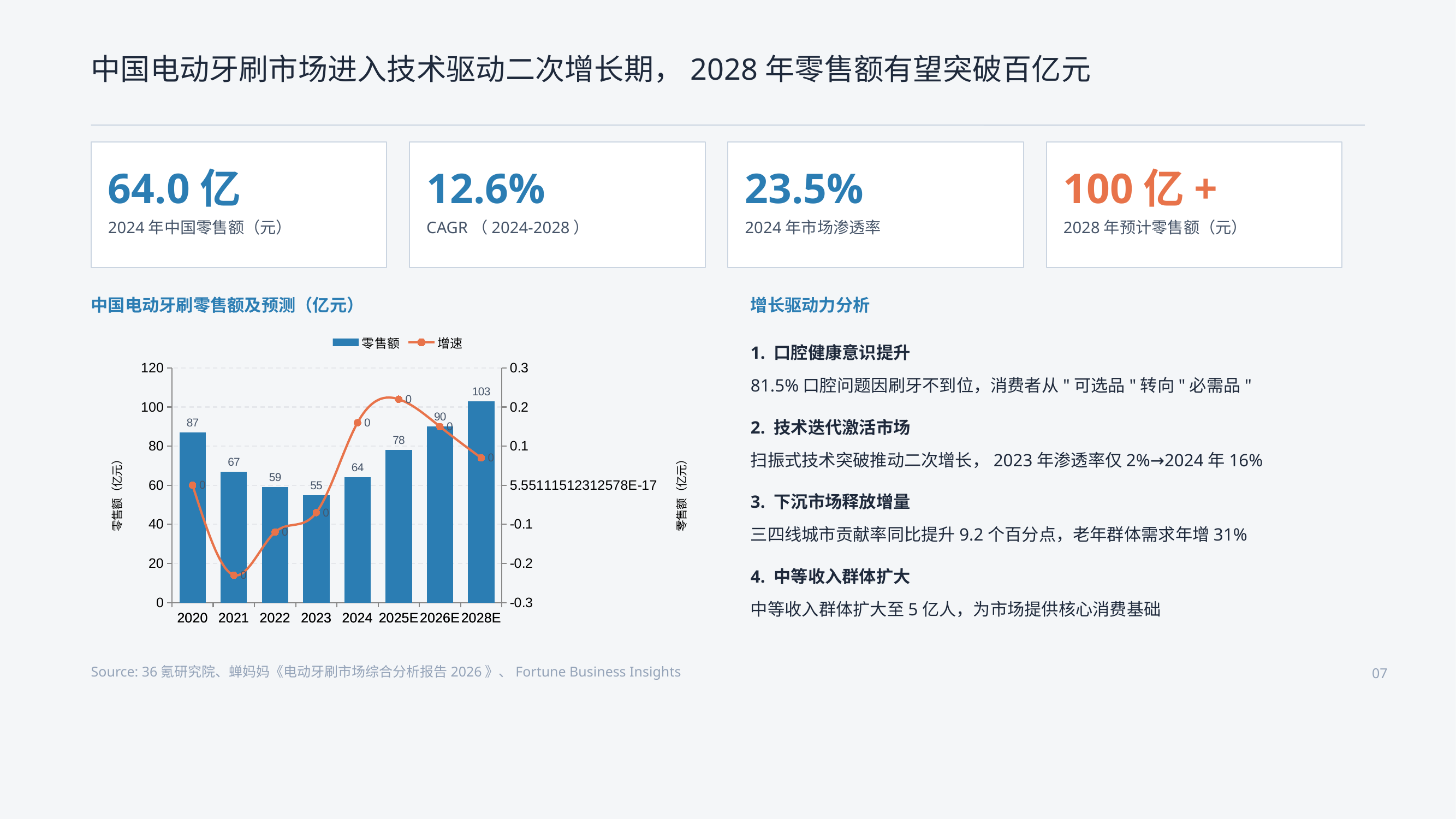
What kind of chart is the 中国电动牙刷零售额及预测（亿元） chart? bar chart with a line In the 中国电动牙刷零售额及预测（亿元） chart, what is the difference between the 零售额 values for 2028E and 2024? 39 In the 中国电动牙刷零售额及预测（亿元） chart, which has the larger 零售额 value, 2021 or 2025E? 2025E What are the two legend entries in the 中国电动牙刷零售额及预测（亿元） chart? 零售额 and 增速 How many series does the legend of the 中国电动牙刷零售额及预测（亿元） chart list? 2 What is the 零售额 value for 2023 in the 中国电动牙刷零售额及预测（亿元） chart? 55 How many years are shown on the x axis of the 中国电动牙刷零售额及预测（亿元） chart? 8 Which year has the lowest 零售额 bar in the 中国电动牙刷零售额及预测（亿元） chart? 2023 In the 中国电动牙刷零售额及预测（亿元） chart, do the 零售额 bars rise or fall from 2020 to 2023? fall What is the 零售额 value for 2028E in the 中国电动牙刷零售额及预测（亿元） chart? 103 What is the 零售额 value for 2020 in the 中国电动牙刷零售额及预测（亿元） chart? 87 Which year has the highest 零售额 bar in the 中国电动牙刷零售额及预测（亿元） chart? 2028E